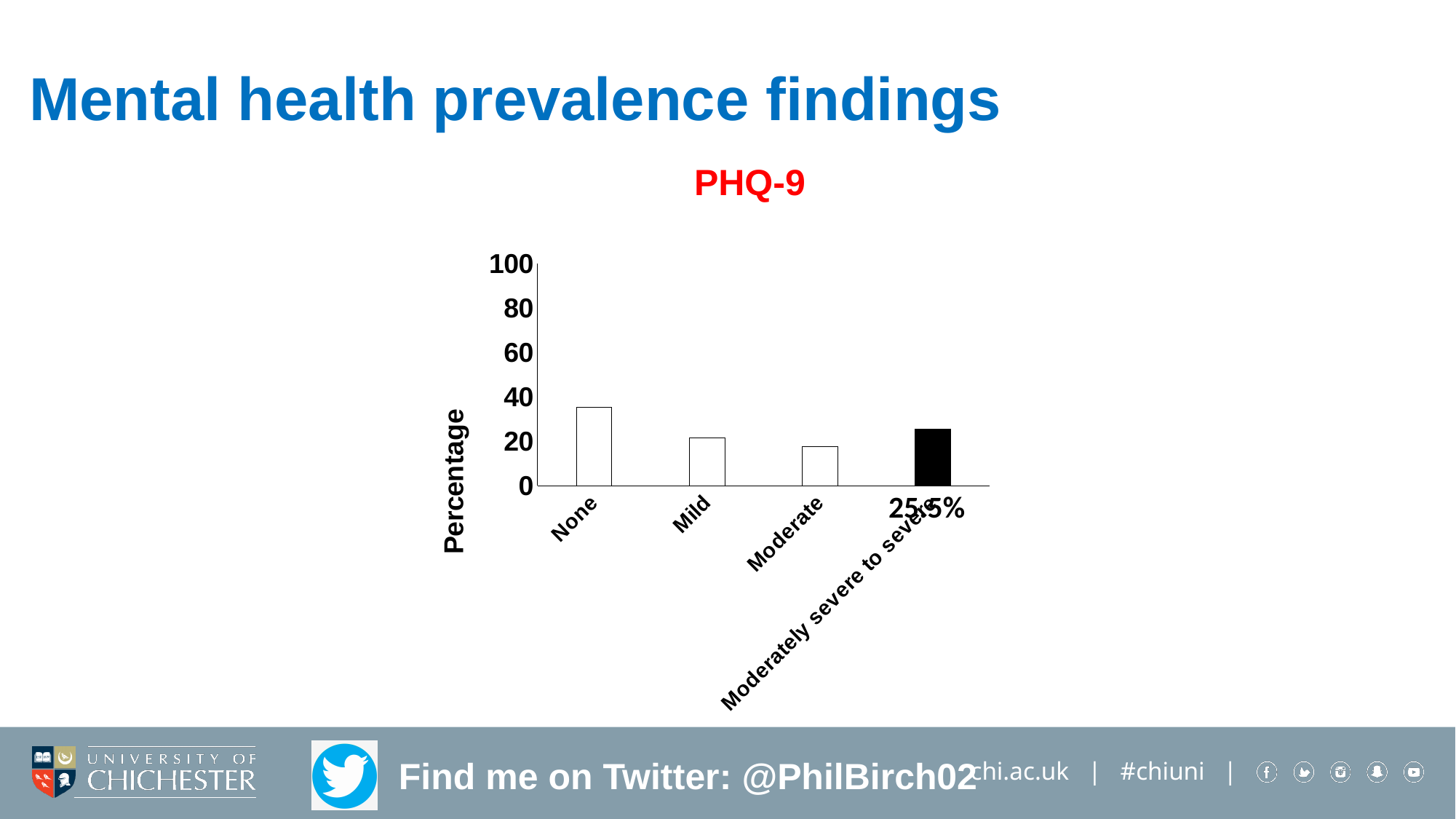
Is the value for Moderately severe to severe greater or less than 20? greater Which category has the highest percentage on the PHQ-9 chart? None What percentage is printed for the Moderately severe to severe category? 25.5% Is the value for None greater or less than 40? less What is the label on the vertical axis of the chart? Percentage How many categories are plotted on the PHQ-9 chart? 4 Is the value for None greater or less than 20? greater Which is larger, the value for None or the value for Mild? None What is the title of the chart? PHQ-9 Which is larger, the value for Moderately severe to severe or the value for Moderate? Moderately severe to severe What kind of chart is shown on the slide? bar chart